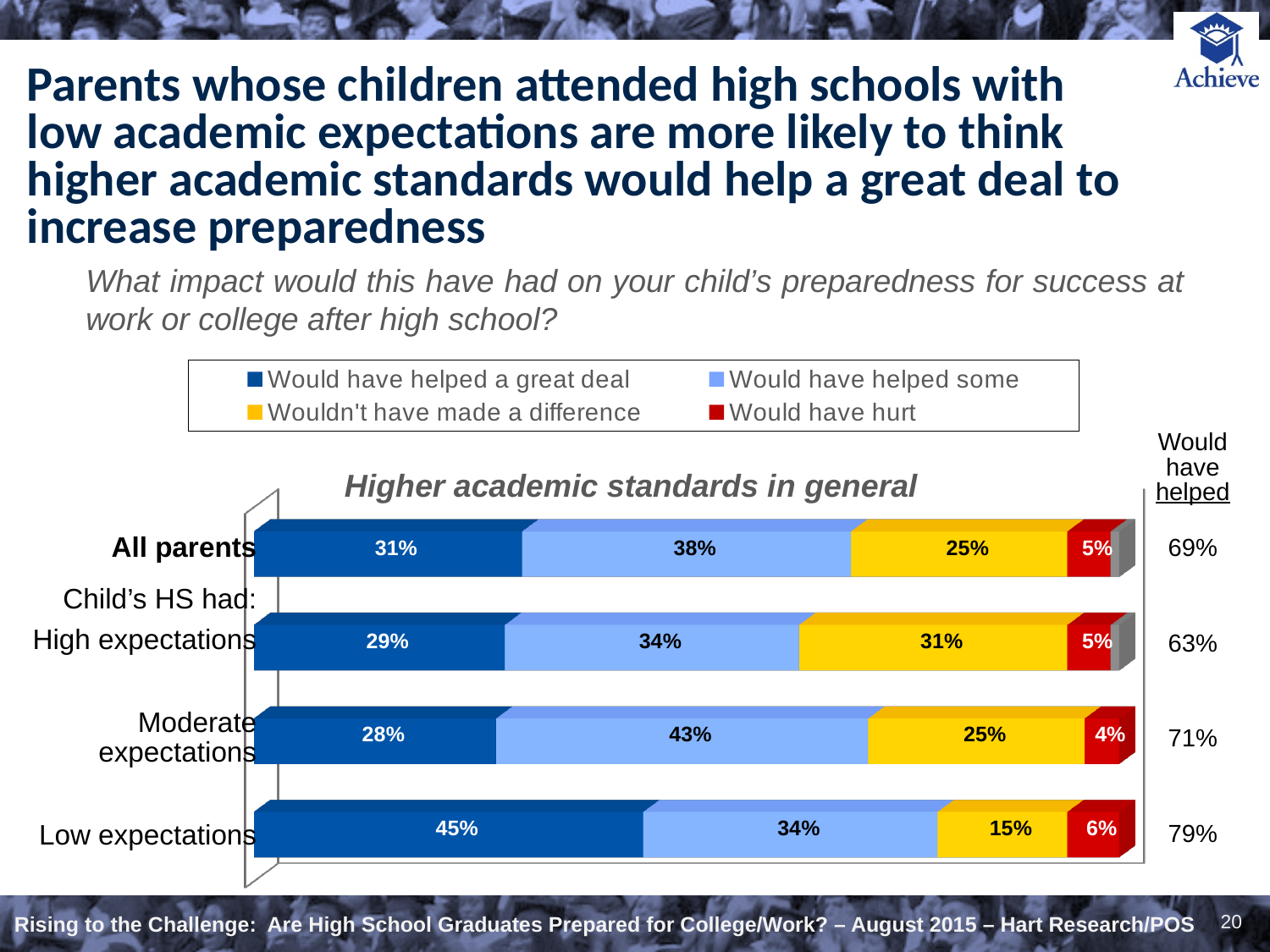
What kind of chart is shown on the slide? Stacked bar chart What percentage of all parents said higher academic standards would have helped a great deal? 31% What is the combined 'would have helped' percentage shown for the low expectations category? 79% What is the difference between the 'would have helped a great deal' share for low expectations and for high expectations? 16 percentage points How many categories (bars) are shown in the chart? 4 Which category has the highest share saying higher academic standards would have helped a great deal? Low expectations Which is larger: the 'would have helped some' share for moderate expectations or for all parents? Moderate expectations What percentage of parents whose child's high school had low expectations said higher academic standards would have helped a great deal? 45% Which category has the lowest share saying higher academic standards wouldn't have made a difference? Low expectations What percentage of parents whose child's high school had moderate expectations said higher academic standards would have helped some? 43% How many series does the legend list? 4 What percentage of parents whose child's high school had high expectations said higher academic standards wouldn't have made a difference? 31%